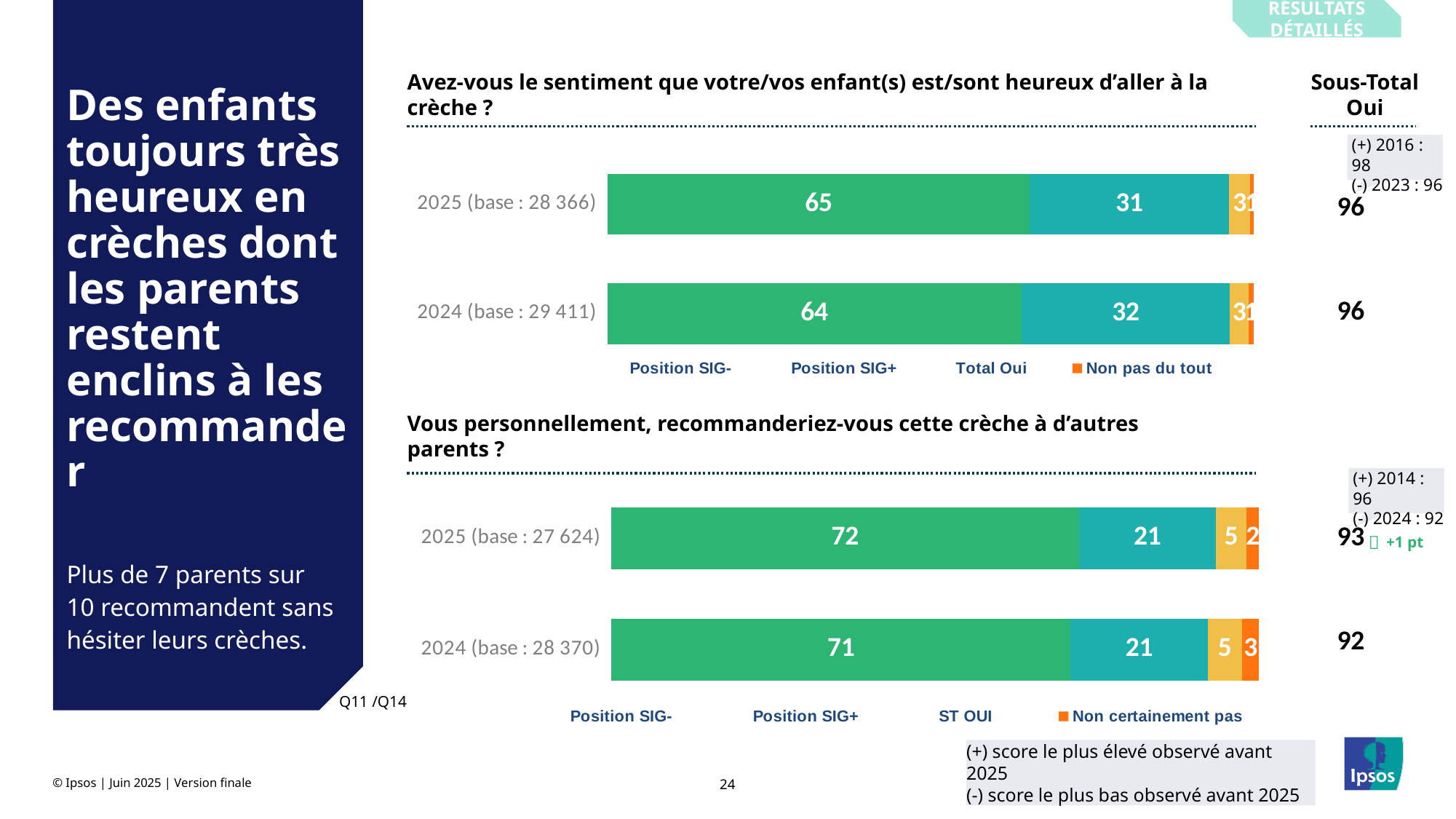
In the bottom chart about recommending the crèche to other parents, what is the total of the 2025 bar (72 + 21 + 5 + 2)? 100 In the top chart about children being happy to go to the crèche, what is the value of the first (dark green) segment for 2024 (base : 29 411)? 64 In the bottom chart about recommending the crèche to other parents, which year has the larger first (dark green) segment, 2025 or 2024? 2025 In the bottom chart about recommending the crèche to other parents, what is the difference between the first (dark green) segment for 2025 and for 2024? 1 In the bottom chart about recommending the crèche to other parents, what is the value of the first (dark green) segment for 2025 (base : 27 624)? 72 In the top chart about children being happy to go to the crèche, what is the value of the first (dark green) segment for 2025 (base : 28 366)? 65 In the bottom chart about recommending the crèche to other parents, what is the Sous-Total Oui for 2025? 93 In the bottom chart about recommending the crèche to other parents, what is the value of the last (orange) segment for 2024 (base : 28 370)? 3 What type of chart is used for the question about recommending the crèche to other parents? Stacked bar chart How many bars does the top chart about children being happy to go to the crèche show? 2 In the top chart about children being happy to go to the crèche, what is the value of the second (teal) segment for 2025? 31 In the top chart about children being happy to go to the crèche, what is the Sous-Total Oui for 2025? 96